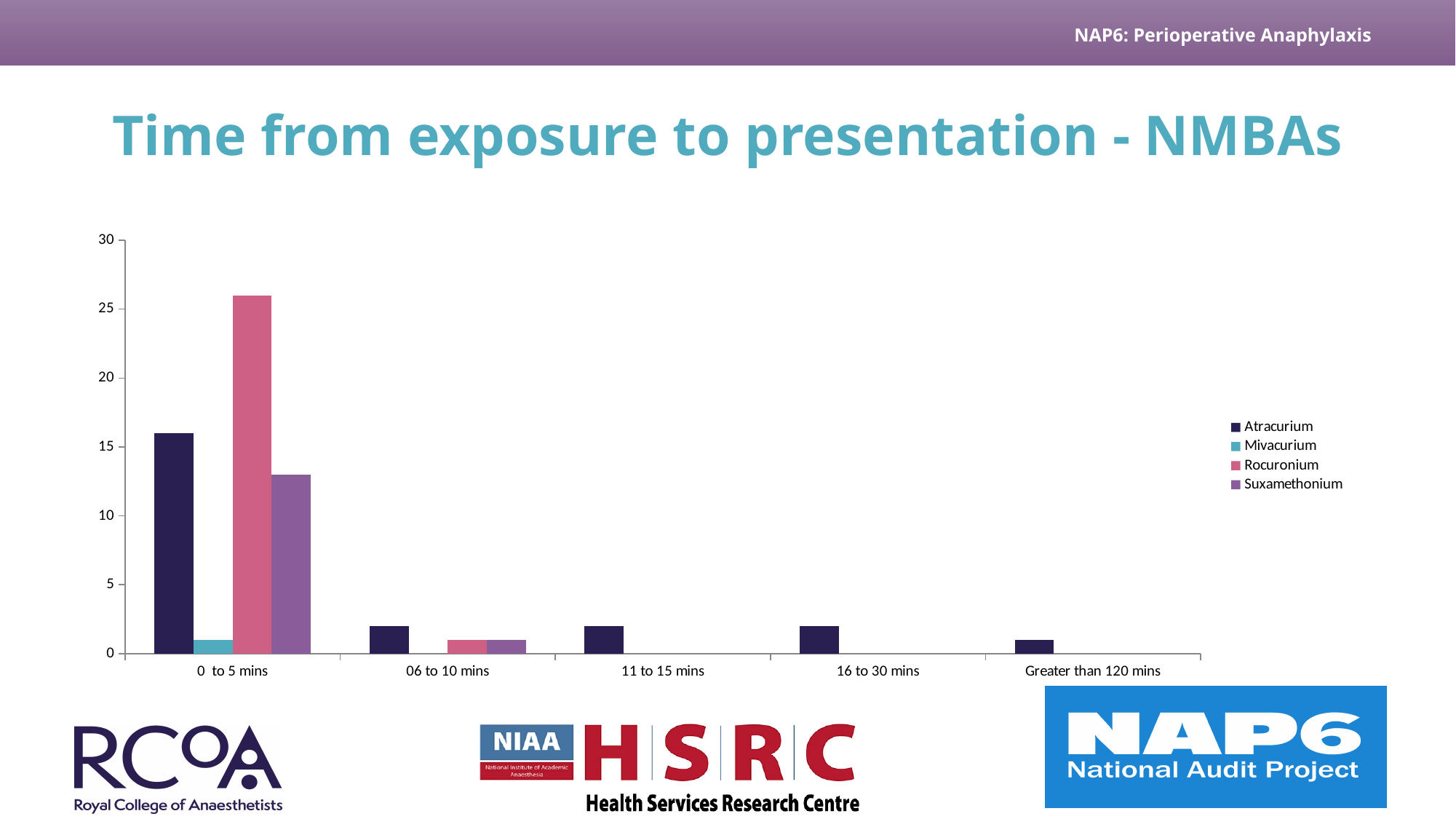
What is the title of the chart slide? Time from exposure to presentation - NMBAs Which series has the tallest bar in the 0 to 5 mins category? Rocuronium In the 0 to 5 mins category, which is larger: Atracurium or Suxamethonium? Atracurium What kind of chart is shown on the slide? bar chart Which series is the only one with a bar in the Greater than 120 mins category? Atracurium Is the value for Atracurium in the 0 to 5 mins category greater or less than 15? greater Is the value for Atracurium in the 06 to 10 mins category greater or less than 5? less Is the value for Suxamethonium in the 0 to 5 mins category greater or less than 15? less Which series has the shortest bar in the 0 to 5 mins category? Mivacurium How many time categories are shown on the x axis? 5 How many series does the legend list? 4